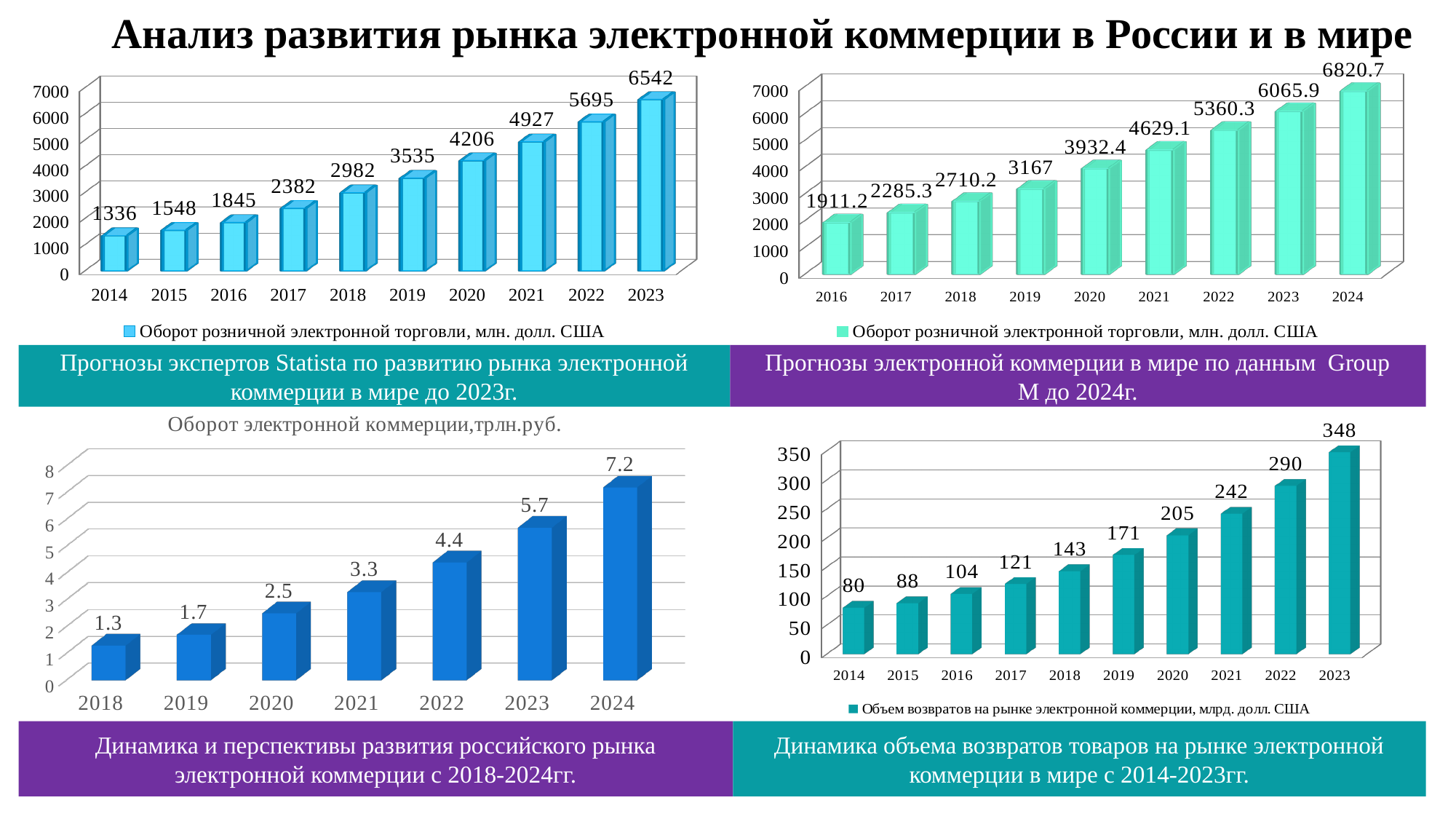
In the top-right chart (Group M forecast), what is the value for 2020? 3932.4 In the bottom-left chart (Оборот электронной коммерции, трлн.руб.), what is the value for 2022? 4.4 In the bottom-right chart (returns volume), which is larger, the value for 2019 or the value for 2020? 2020 In the top-left chart (Statista forecast), which year has the highest value? 2023 What type of chart is the bottom-right chart (returns volume)? bar chart In the bottom-right chart (returns volume), what is the value for 2017? 121 In the bottom-left chart (Оборот электронной коммерции, трлн.руб.), what is the difference between the values for 2024 and 2023? 1.5 In the top-right chart (Group M forecast), which year has the lowest value? 2016 In the bottom-left chart (Оборот электронной коммерции, трлн.руб.), do the values rise or fall from 2018 to 2024? rise In the top-right chart (Group M forecast), how many years are shown on the x axis? 9 In the top-left chart (Statista forecast), what is the difference between the values for 2023 and 2022? 847 In the top-left chart (Statista forecast), what is the value for 2019? 3535